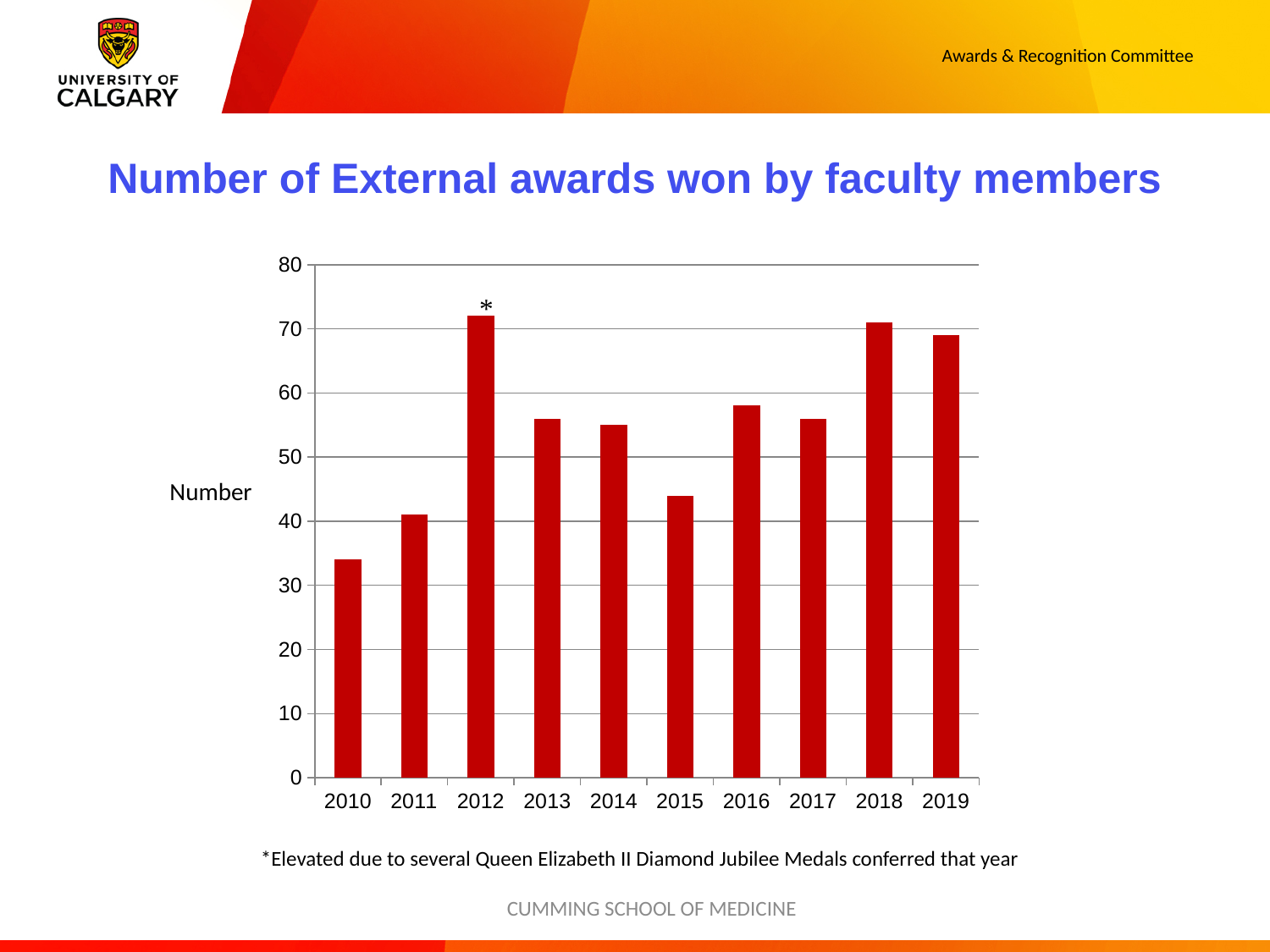
Is the value for 2011 greater or less than 50? less How many years are shown on the x axis of the chart? 10 Which is larger, the value for 2015 or the value for 2016? 2016 Is the value for 2010 greater or less than 40? less Which is larger, the value for 2010 or the value for 2011? 2011 Is the value for 2015 greater or less than 50? less What kind of chart is shown on the slide? bar chart Which year's bar is marked with an asterisk? 2012 Which year has the lowest number of external awards? 2010 What is the title of the chart on the slide? Number of External awards won by faculty members